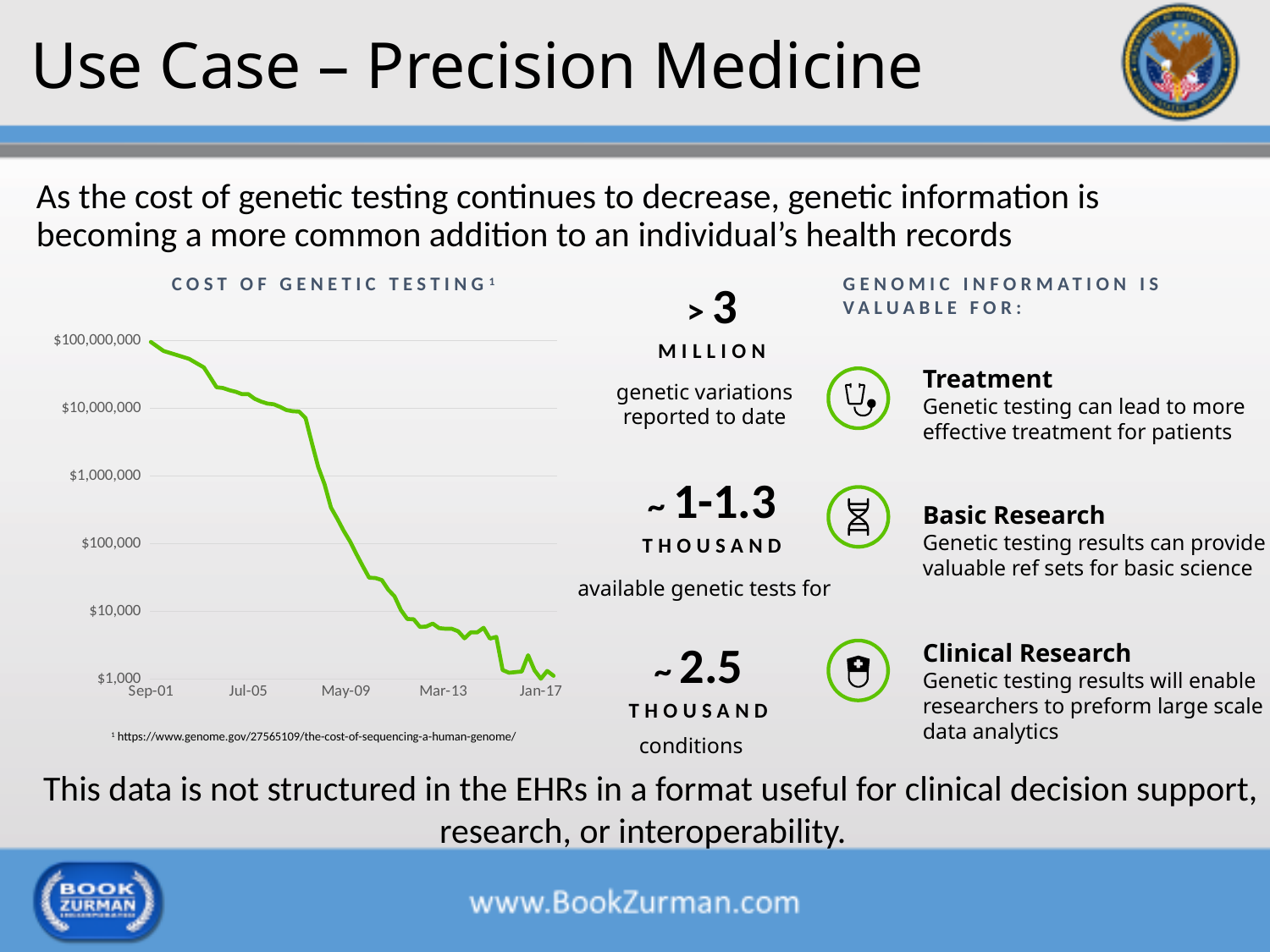
What is the title of the chart on the left of the slide? COST OF GENETIC TESTING In the "COST OF GENETIC TESTING" chart, is the value at Mar-13 greater or less than $10,000? less In the "COST OF GENETIC TESTING" chart, which is larger, the value at Sep-01 or the value at Jan-17? Sep-01 In the "COST OF GENETIC TESTING" chart, is the value at Jul-05 greater or less than $1,000,000? greater In the "COST OF GENETIC TESTING" chart, do the values rise or fall from Sep-01 to Jan-17? fall How many date labels are shown on the x-axis of the "COST OF GENETIC TESTING" chart? 5 What kind of chart is shown under the title "COST OF GENETIC TESTING"? line chart What is the highest value labelled on the y-axis of the "COST OF GENETIC TESTING" chart? $100,000,000 What is the last date label on the x-axis of the "COST OF GENETIC TESTING" chart? Jan-17 In the "COST OF GENETIC TESTING" chart, is the value at Jan-17 greater or less than $10,000? less In the "COST OF GENETIC TESTING" chart, at which x-axis date is the value highest? Sep-01